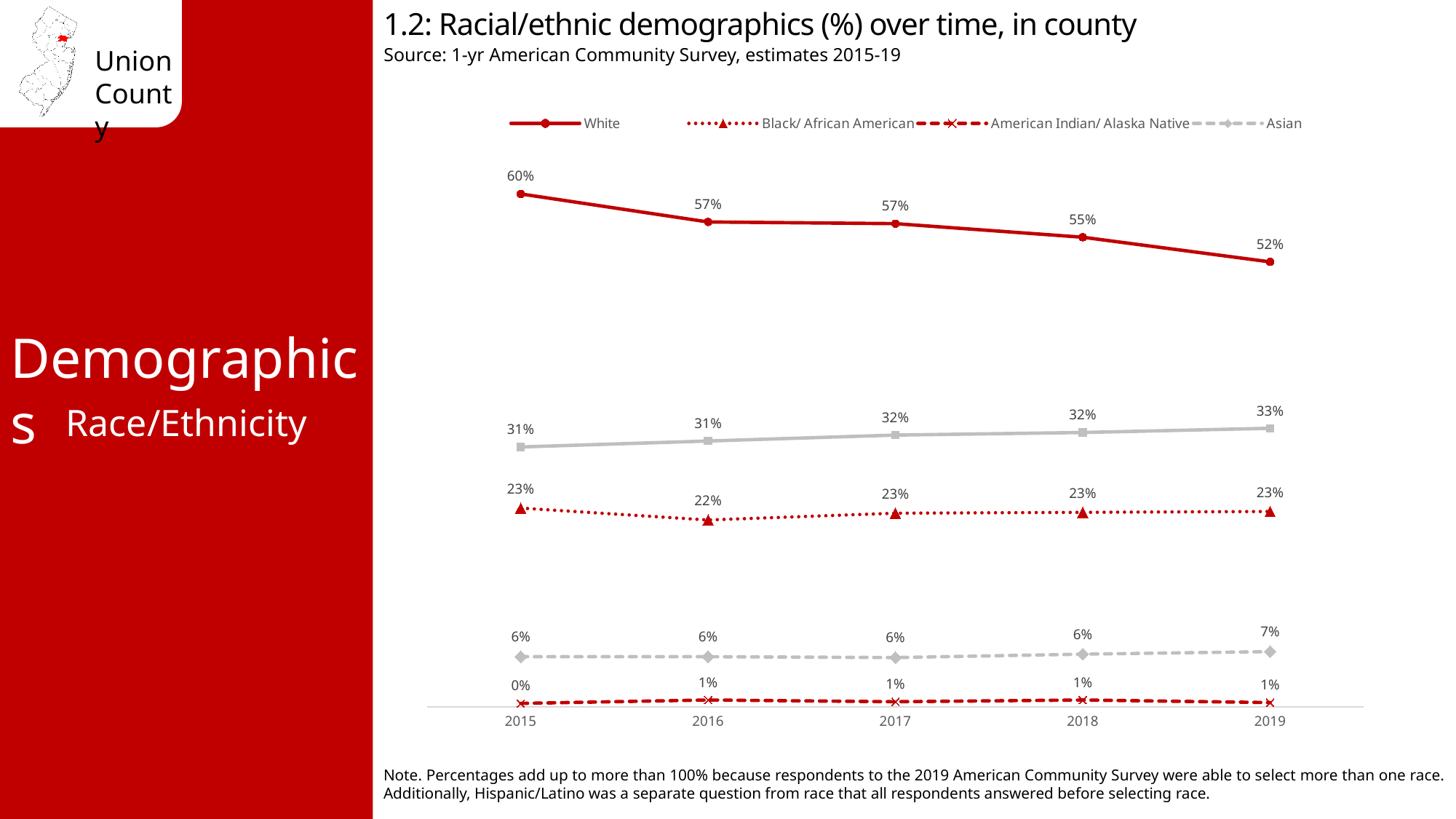
What is the value for Black/ African American in 2016? 22% What is the value for White in 2019? 52% In 2019, which is larger: Black/ African American or Asian? Black/ African American How many years are plotted on the x axis? 5 What is the value for Asian in 2019? 7% In which year is the White share highest? 2015 What is the value for White in 2015? 60% By how many percentage points did the White share fall from 2015 to 2019? 8 percentage points What kind of chart is shown on the slide? Line chart What is the title of the chart? 1.2: Racial/ethnic demographics (%) over time, in county What is the value for American Indian/ Alaska Native in 2015? 0% Does the White series rise or fall from 2015 to 2019? Fall